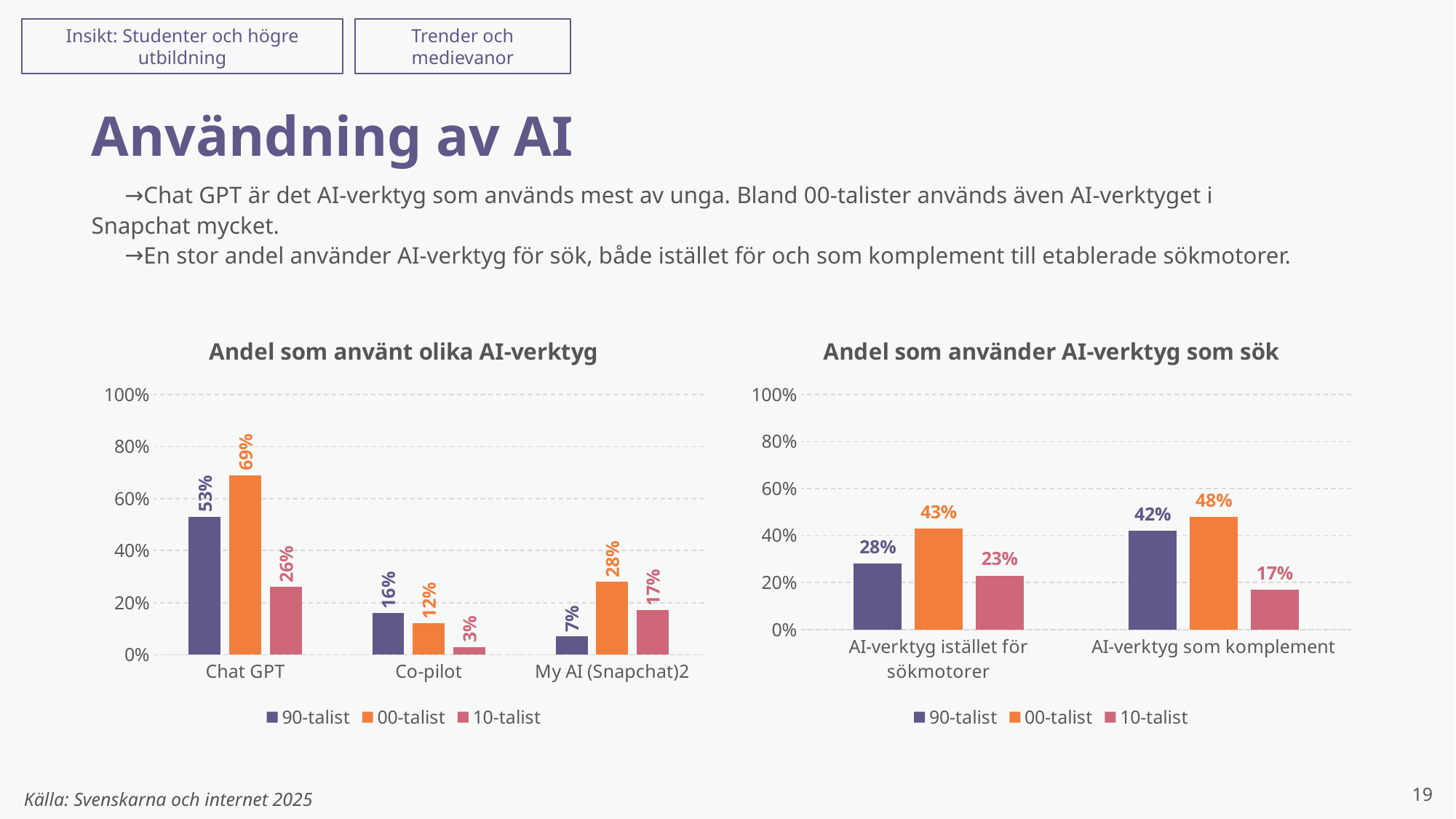
What kind of chart is 'Andel som använt olika AI-verktyg'? Bar chart How many series does the legend of the chart 'Andel som använder AI-verktyg som sök' list? 3 In the chart 'Andel som använder AI-verktyg som sök', what is the value for 10-talist for 'AI-verktyg istället för sökmotorer'? 23% In the chart 'Andel som använt olika AI-verktyg', what is the value for 10-talist for Co-pilot? 3% In the chart 'Andel som använder AI-verktyg som sök', which series has the lowest value for 'AI-verktyg som komplement'? 10-talist In the chart 'Andel som använt olika AI-verktyg', what is the value for 00-talist for Chat GPT? 69% In the chart 'Andel som använt olika AI-verktyg', how many categories are shown on the x axis? 3 In the chart 'Andel som använt olika AI-verktyg', which series has the highest value for My AI (Snapchat)? 00-talist In the chart 'Andel som använder AI-verktyg som sök', what is the value for 90-talist for 'AI-verktyg som komplement'? 42% In the chart 'Andel som använder AI-verktyg som sök', which is larger: the 00-talist value for 'AI-verktyg istället för sökmotorer' or for 'AI-verktyg som komplement'? AI-verktyg som komplement In the chart 'Andel som använt olika AI-verktyg', what is the difference between the 00-talist and 90-talist values for Chat GPT? 16 percentage points In the chart 'Andel som använder AI-verktyg som sök', what is the difference between the 00-talist and 10-talist values for 'AI-verktyg som komplement'? 31 percentage points